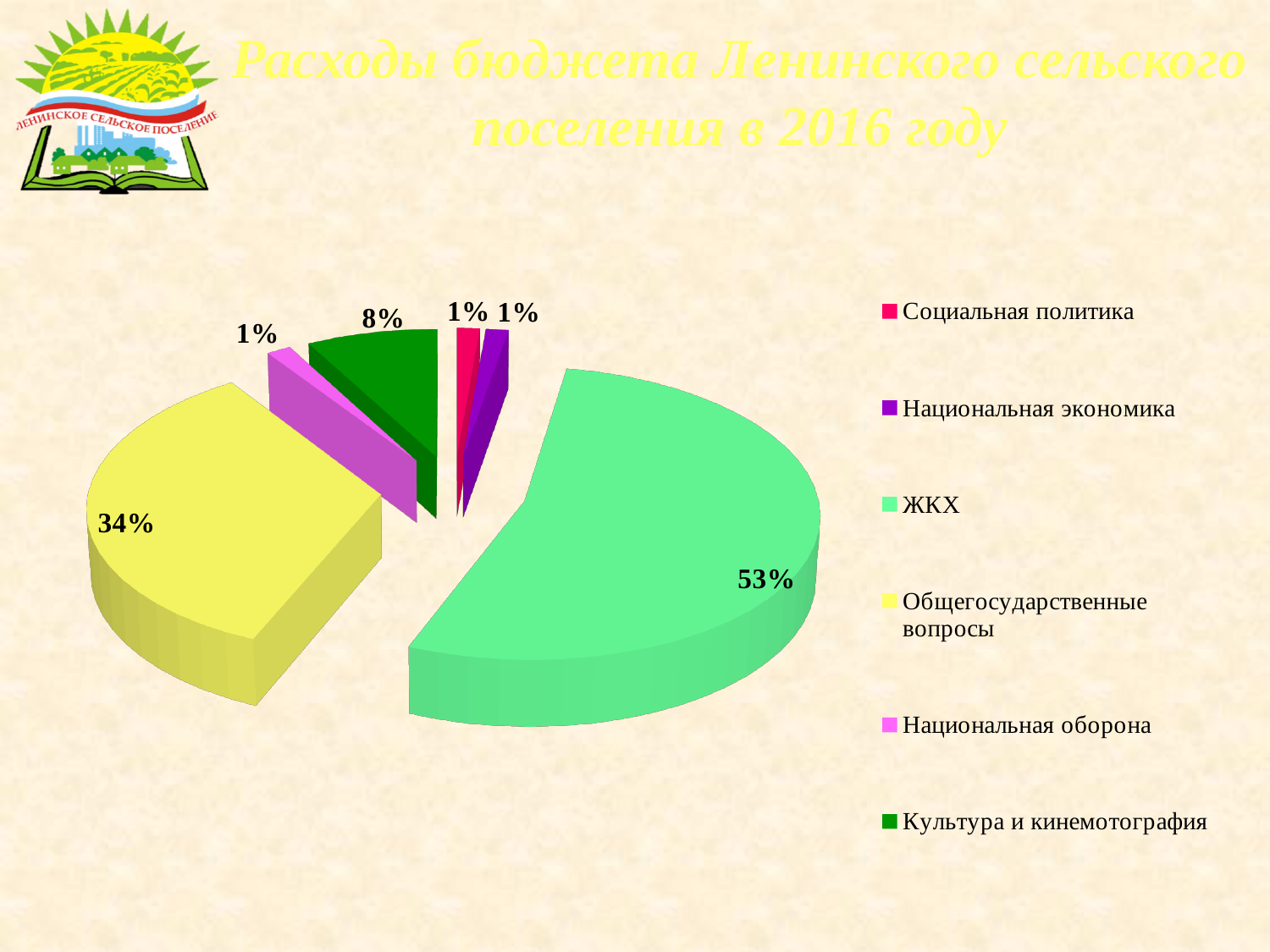
What is the difference in percentage points between ЖКХ and Общегосударственные вопросы? 19 What colour is the slice for Общегосударственные вопросы? yellow Which category has the largest share of the pie? ЖКХ What share of the pie does Национальная оборона have? 1% What kind of chart is shown on the slide? pie chart How many categories does the legend list? 6 What is the title of the chart slide? Расходы бюджета Ленинского сельского поселения в 2016 году Which is larger, the share for Культура и кинемотография or the share for Социальная политика? Культура и кинемотография What share of the pie does Общегосударственные вопросы have? 34% What is the difference in percentage points between Общегосударственные вопросы and Культура и кинемотография? 26 What share of the pie does ЖКХ have? 53% What share of the pie does Культура и кинемотография have? 8%